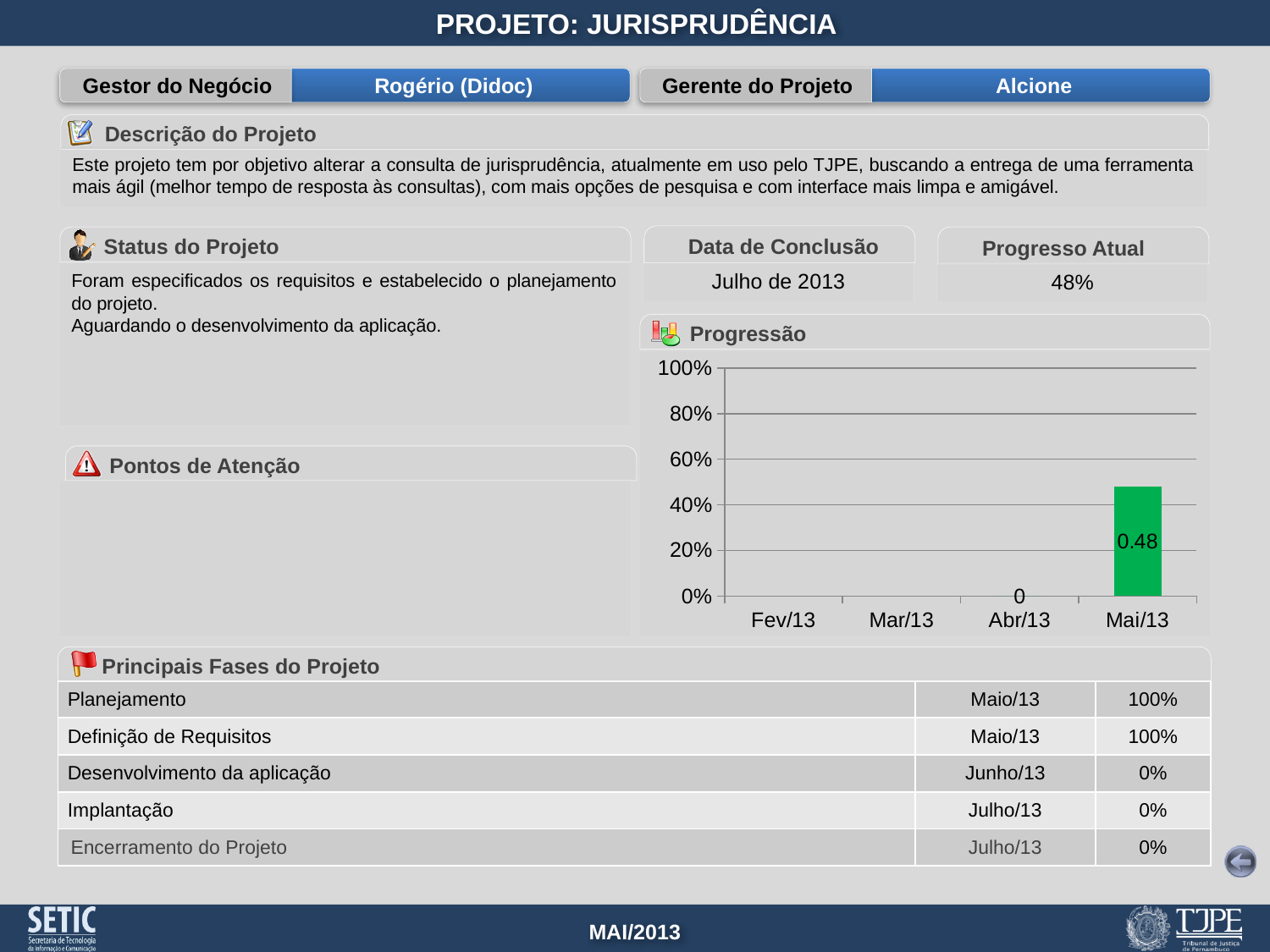
In the Progressão chart, how many months are shown on the x axis? 4 What kind of chart is the Progressão chart? bar chart In the Progressão chart, what is the value shown for Abr/13? 0 In the Progressão chart, which month has the highest value? Mai/13 In the Progressão chart, is the value for Mai/13 greater or less than 60%? less In the Progressão chart, does the value rise or fall from Abr/13 to Mai/13? rise What is the title of the chart on the slide? Progressão What is the highest value labelled on the y axis of the Progressão chart? 100% In the Progressão chart, what is the value shown for Mai/13? 0.48 In the Progressão chart, which is larger, the value for Abr/13 or the value for Mai/13? Mai/13 In the Progressão chart, is the value for Mai/13 greater or less than 40%? greater In the Progressão chart, what is the difference between the values for Mai/13 and Abr/13? 0.48